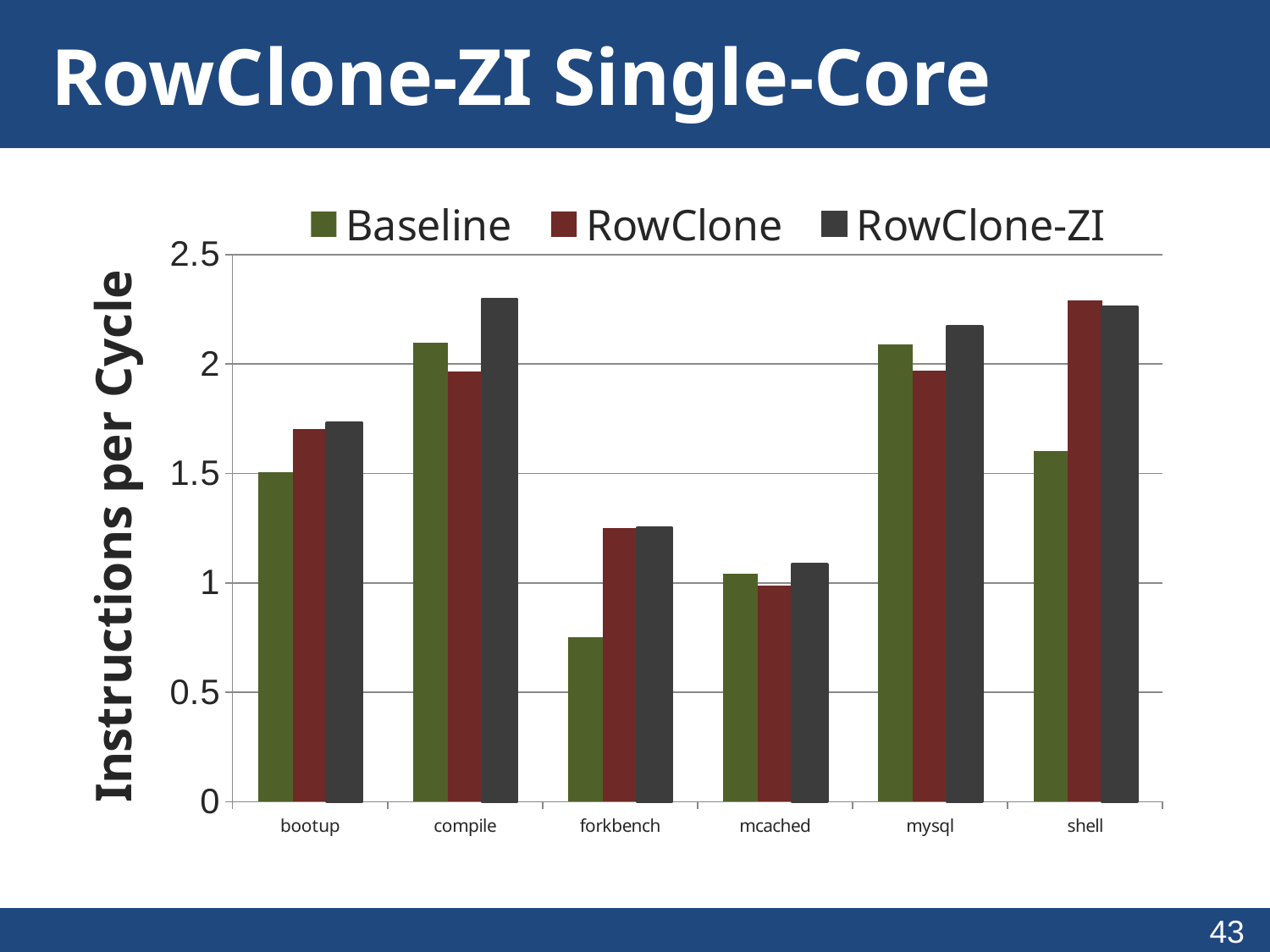
For shell, which is larger: the Baseline value or the RowClone value? RowClone Which workload has the lowest Baseline value? forkbench How many workload categories are shown on the x axis? 6 What is the title of the y axis? Instructions per Cycle Which workload has the highest RowClone-ZI value? compile What kind of chart is shown on the slide? bar chart For compile, which is larger: the Baseline value or the RowClone value? Baseline Is the RowClone value for forkbench greater or less than 1? greater What are the three series named in the legend? Baseline, RowClone, RowClone-ZI Is the Baseline value for forkbench greater or less than 1? less Is the RowClone-ZI value for compile greater or less than 2? greater How many series does the legend list? 3